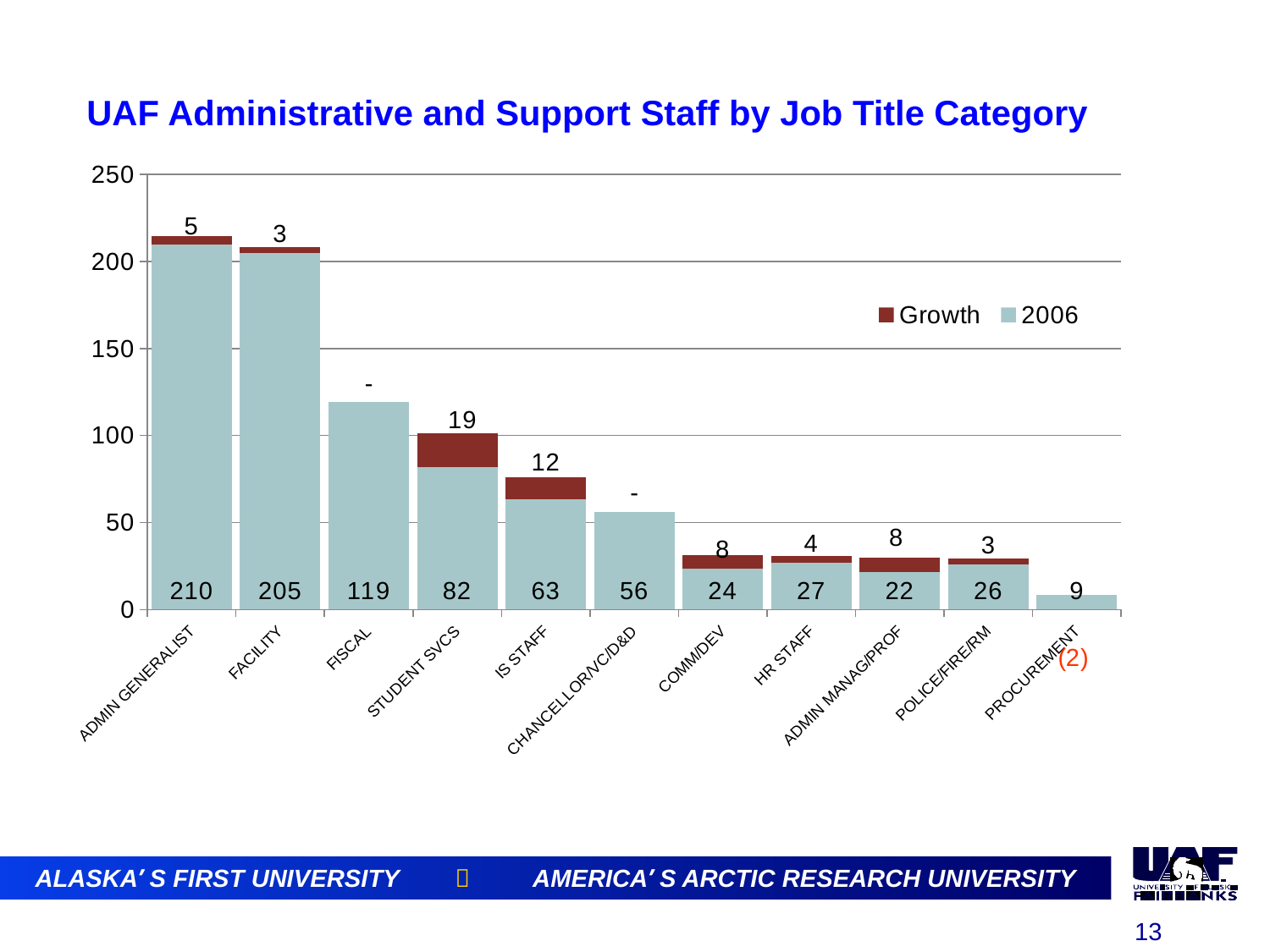
Which has a larger Growth value, IS STAFF or HR STAFF? IS STAFF What is the 2006 value for ADMIN GENERALIST? 210 What is the 2006 value for CHANCELLOR/VC/D&D? 56 How many series does the legend list? 2 What is the total of the stacked bar for STUDENT SVCS (2006 plus Growth)? 101 How many job title categories are shown on the x axis? 11 What is the Growth value for STUDENT SVCS? 19 Which job title category has the highest 2006 value? ADMIN GENERALIST What is the difference between the 2006 values for FACILITY and FISCAL? 86 Which job title category has the lowest 2006 value? PROCUREMENT What is the title of the chart? UAF Administrative and Support Staff by Job Title Category What kind of chart is shown on the slide? Stacked bar chart